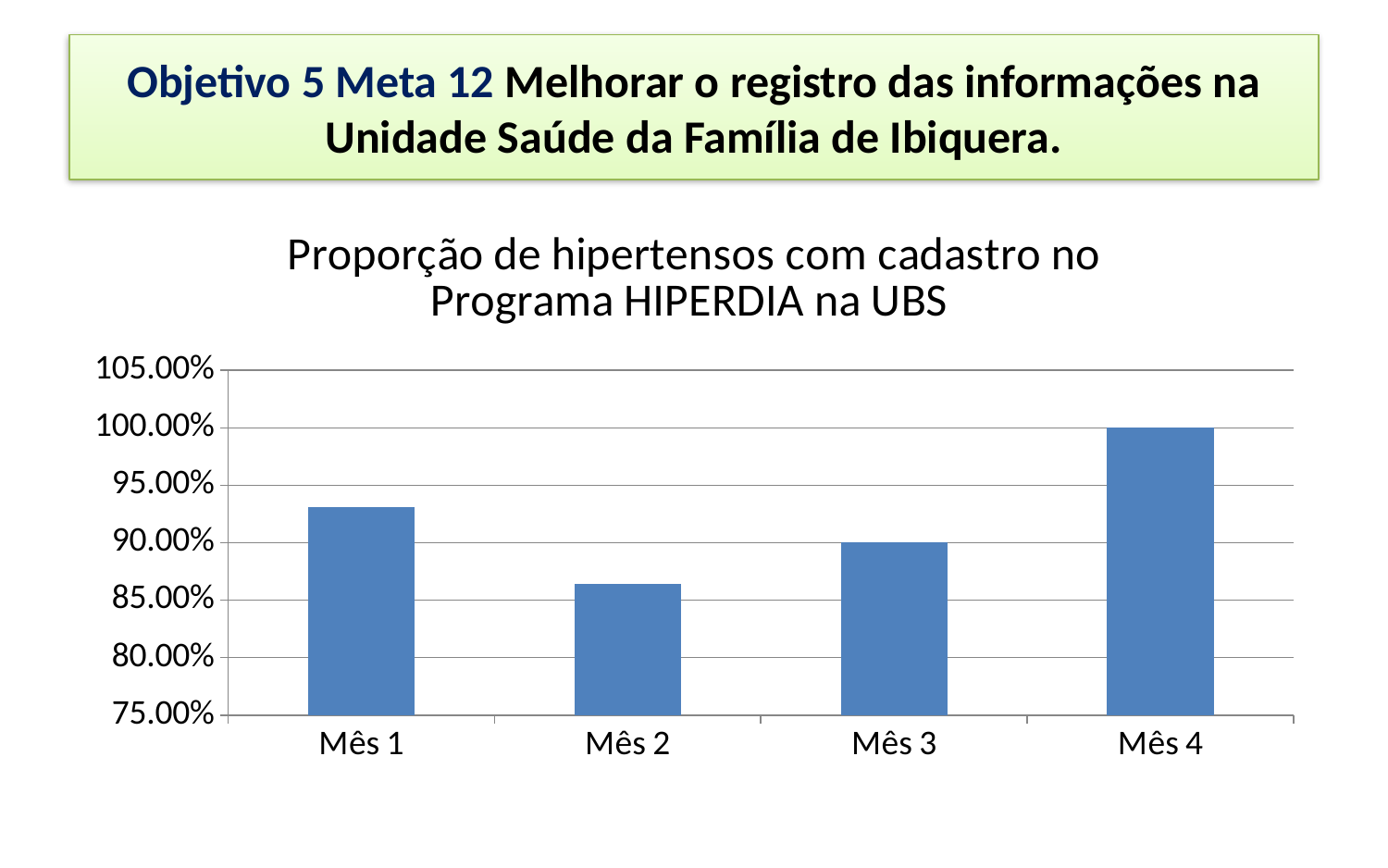
Is the value for Mês 1 greater or less than 90.00%? greater What is the value for Mês 4? 100.00% Is the value for Mês 1 greater or less than 95.00%? less Which month has the lowest proportion in the chart? Mês 2 What type of chart is shown on the slide? bar chart Is the value for Mês 2 greater or less than 90.00%? less Which is larger, the value for Mês 2 or the value for Mês 4? Mês 4 What is the value for Mês 3? 90.00% What is the title of the chart? Proporção de hipertensos com cadastro no Programa HIPERDIA na UBS How many categories are shown on the x axis of the chart? 4 Which is larger, the value for Mês 1 or the value for Mês 3? Mês 1 Which month has the highest proportion in the chart? Mês 4